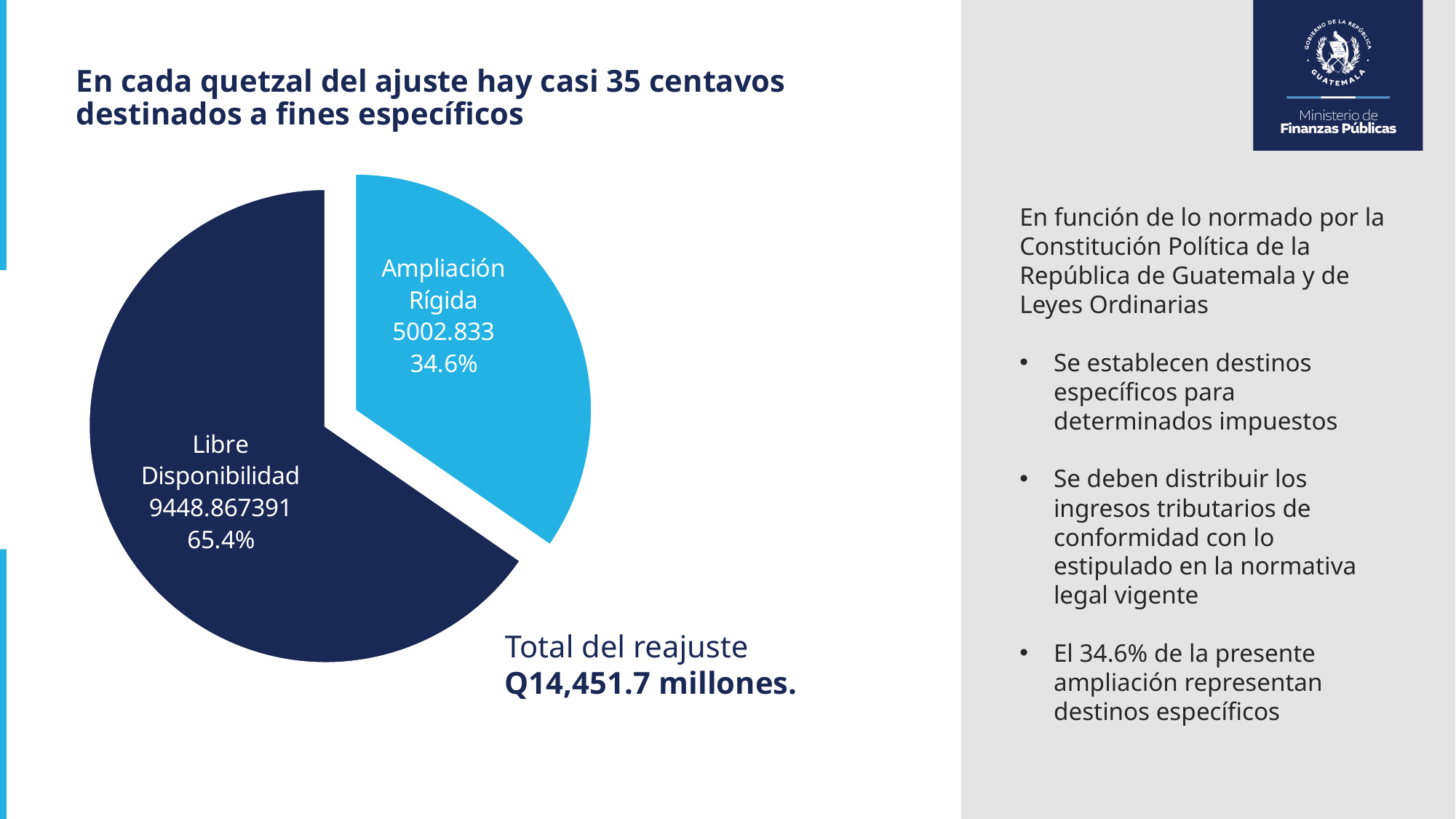
What total amount of the reajuste is stated next to the pie chart? Q14,451.7 millones What share of the pie does Libre Disponibilidad represent? 65.4% What value is shown for the Ampliación Rígida slice? 5002.833 What kind of chart is shown on the slide? Pie chart What colour is the Ampliación Rígida slice? Light blue What share of the pie does Ampliación Rígida represent? 34.6% Which slice of the pie chart is the smallest? Ampliación Rígida What value is shown for the Libre Disponibilidad slice? 9448.867391 Which slice of the pie chart is the largest? Libre Disponibilidad By how many percentage points does the Libre Disponibilidad share exceed the Ampliación Rígida share? 30.8 percentage points How many slices does the pie chart have? 2 Which is larger, Libre Disponibilidad or Ampliación Rígida? Libre Disponibilidad